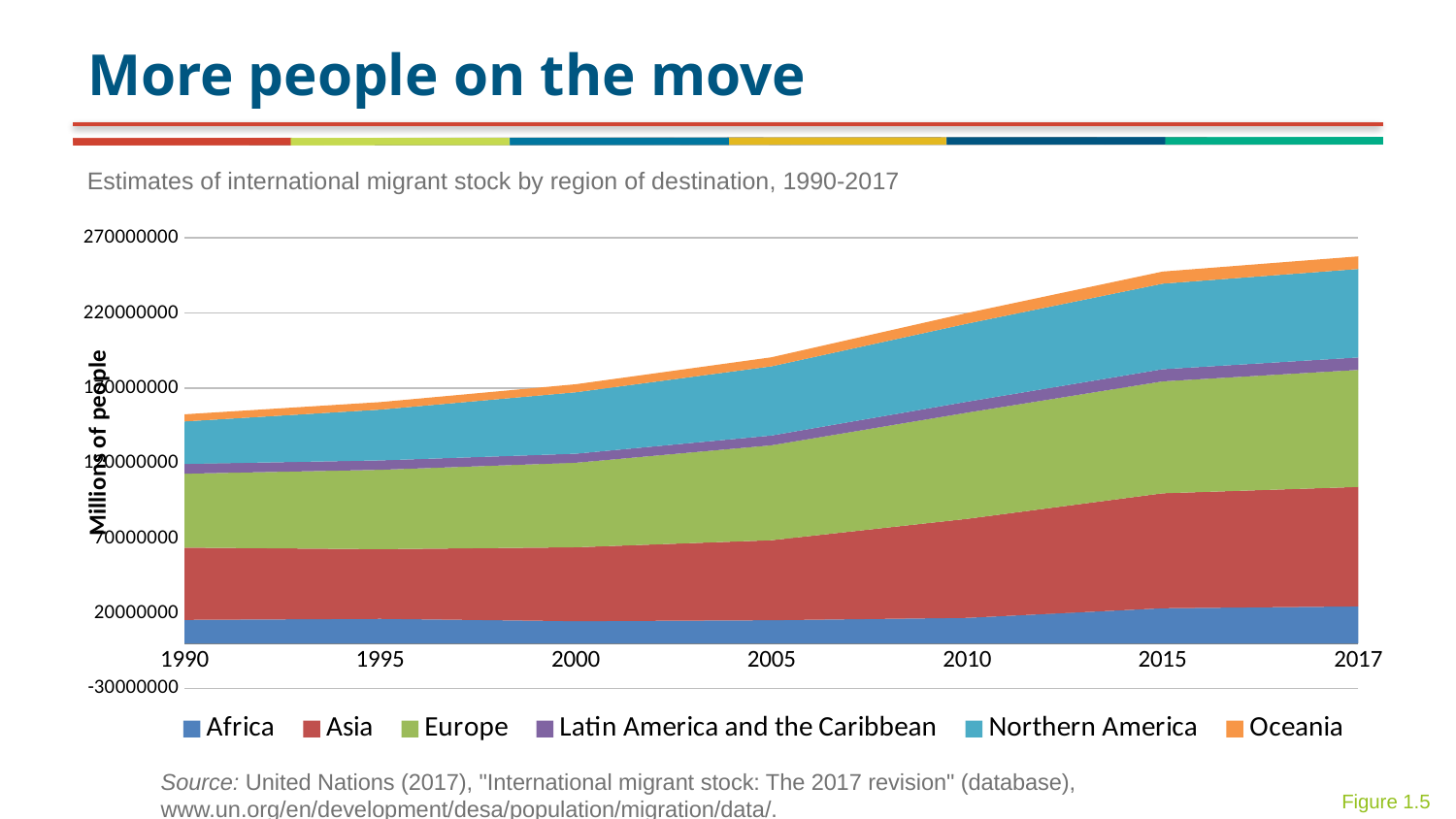
In 2017, which region has the larger migrant stock, Europe or Oceania? Europe Which year is the last point on the x axis? 2017 What is the label on the y axis? Millions of people How many series does the legend list? 6 How many years are labelled on the x axis? 7 Is the total migrant stock in 2017 greater or less than 220000000? greater Which region is listed first in the legend? Africa Is the total migrant stock in 1990 greater or less than 170000000? less Which year is the first point on the x axis? 1990 In 2017, which region has the larger migrant stock, Asia or Africa? Asia What kind of chart is shown on the slide? Stacked area chart Does the total international migrant stock rise or fall from 1990 to 2017? Rise